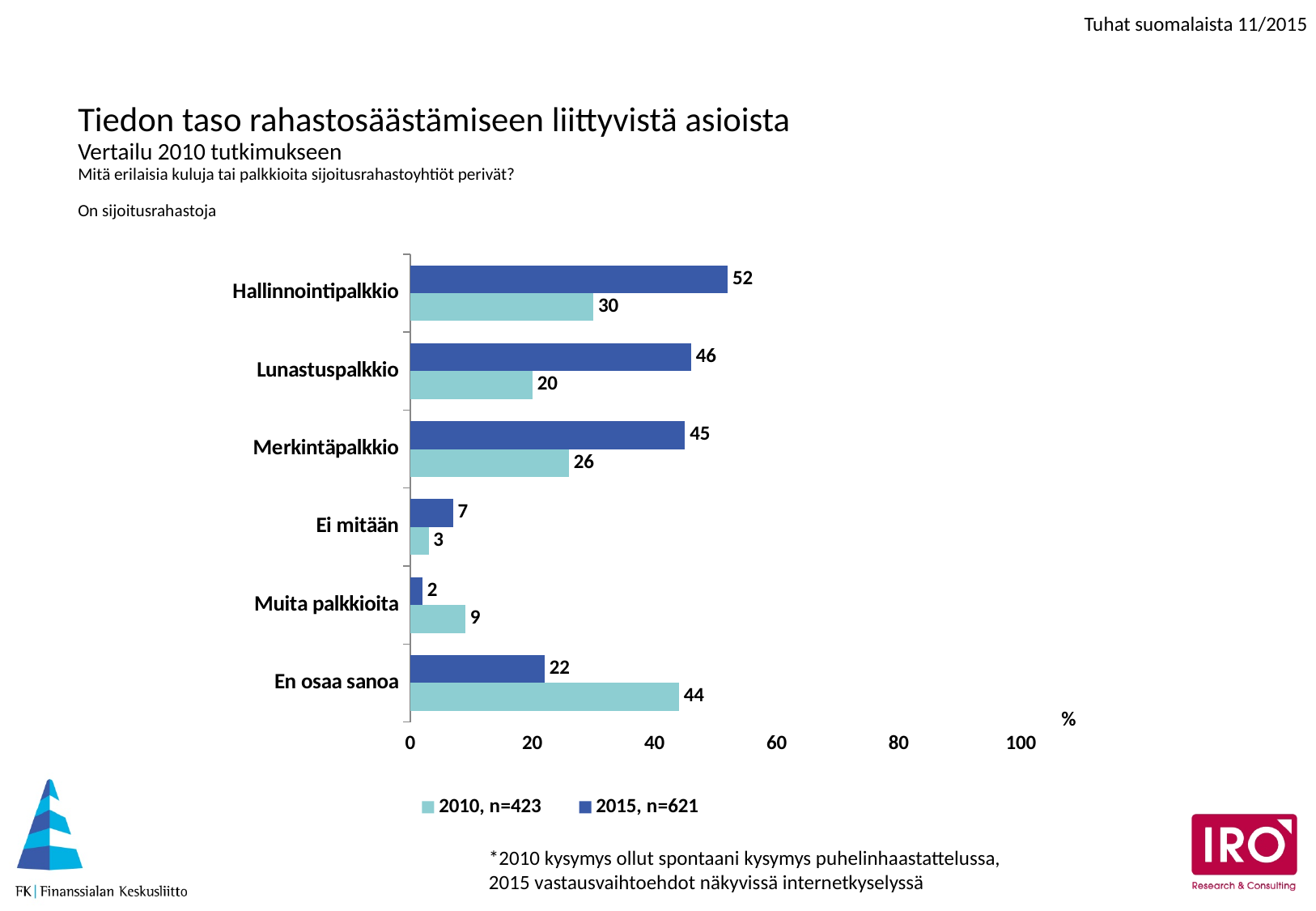
Which category has the lowest 2015 value? Muita palkkioita What is the 2015 value for Hallinnointipalkkio? 52 What is the difference between the 2015 and 2010 values for Merkintäpalkkio? 19 Which category has the highest 2015 value? Hallinnointipalkkio How many categories are shown on the chart? 6 What is the 2010 value for En osaa sanoa? 44 How many series does the legend list? 2 Which is larger for Muita palkkioita, the 2010 value or the 2015 value? 2010 Is the 2015 value for Lunastuspalkkio greater or less than 40? greater What is the 2010 value for Lunastuspalkkio? 20 Which category has the lowest 2010 value? Ei mitään What kind of chart is shown on the slide? bar chart